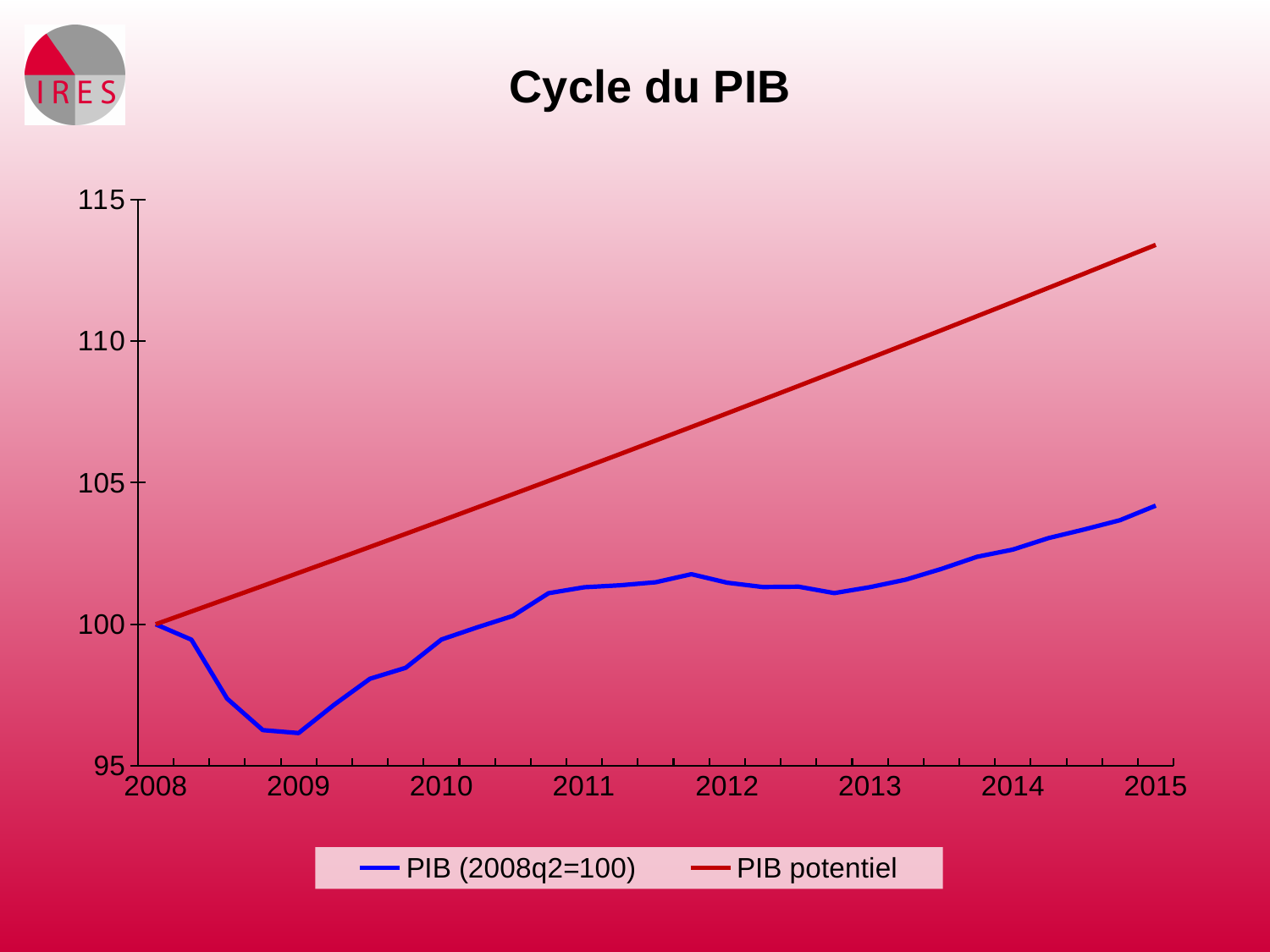
Does the PIB (2008q2=100) series rise or fall between 2008 and 2009? fall Which series is drawn in red? PIB potentiel What kind of chart is shown on the slide? line chart Is the value of PIB (2008q2=100) at the start of 2009 greater or less than 100? less What is the title of the chart? Cycle du PIB How many year labels are shown on the x axis? 8 Which series has the higher value in 2013, PIB (2008q2=100) or PIB potentiel? PIB potentiel How many series does the legend list? 2 Is the value of PIB potentiel in 2015 greater or less than 110? greater What is the value of PIB (2008q2=100) at the start of 2008? 100 Is the value of PIB (2008q2=100) in 2015 greater or less than 105? less Does the PIB potentiel series rise or fall from 2008 to 2015? rise